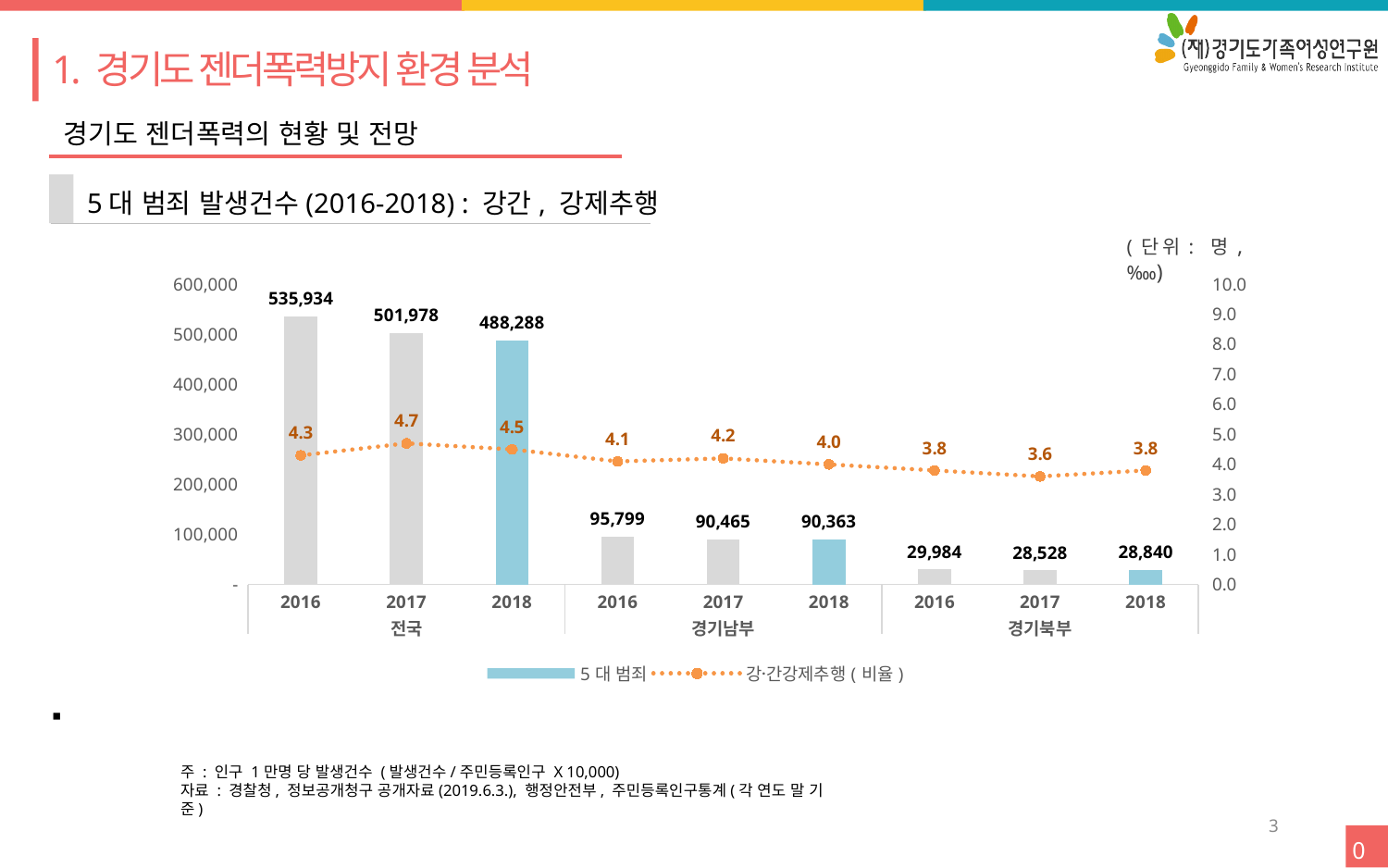
What is the value of the 5대 범죄 bar for 전국 in 2016? 535,934 What kind of chart is shown on the slide? Combined bar and line chart Which group and year has the highest 5대 범죄 bar? 전국 2016 Is the 5대 범죄 value for 경기남부 in 2016 greater or less than 100,000? less Which group and year has the lowest 강·간강제추행 (비율) value? 경기북부 2017 How many series does the legend list? 2 What is the value of the 5대 범죄 bar for 경기남부 in 2018? 90,363 What is the 강·간강제추행 (비율) value for 경기북부 in 2017? 3.6 Do the 5대 범죄 bars for 전국 rise or fall from 2016 to 2018? fall What is the 강·간강제추행 (비율) value for 전국 in 2017? 4.7 What is the difference between the 5대 범죄 values for 전국 in 2016 and 2017? 33,956 Which is larger, the 5대 범죄 value for 경기북부 in 2017 or in 2018? 2018